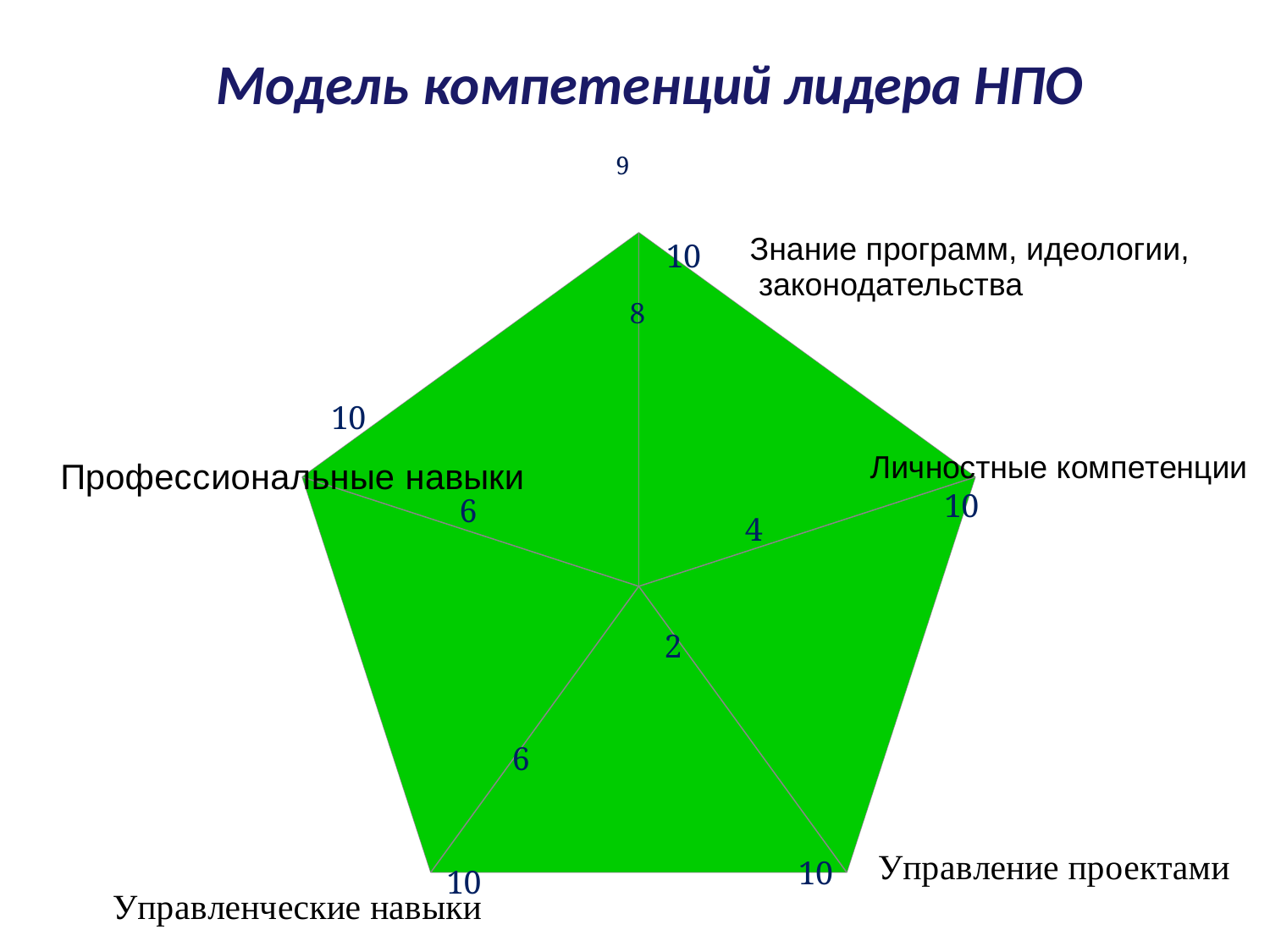
What is the value for Знание программ, идеологии, законодательства? 10 What is the value for Личностные компетенции? 10 What colour is the filled area of the radar chart? green What is the value for Профессиональные навыки? 10 How many categories (axes) does the radar chart have? 5 Do all five categories have the same value? yes Is the value for Профессиональные навыки greater or less than 8? greater Is the value for Управление проектами greater or less than 6? greater What is the value for Управление проектами? 10 What is the value for Управленческие навыки? 10 What kind of chart is shown on the slide? radar chart What is the title of the chart? Модель компетенций лидера НПО